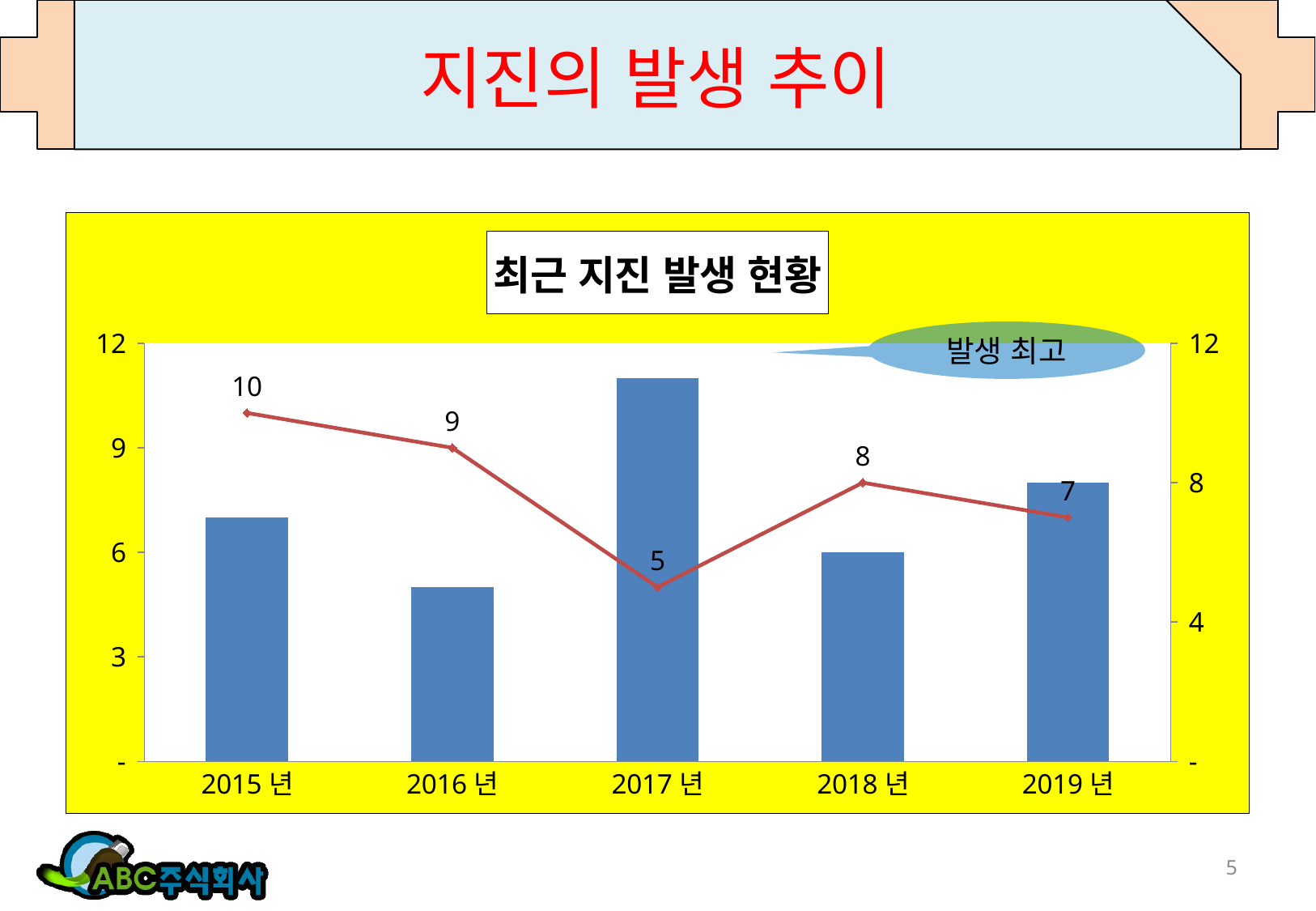
What is the difference between the line values for 2015 년 and 2017 년? 5 Which year has the larger line value, 2016 년 or 2018 년? 2016 년 On the left axis, is the bar for 2016 년 greater or less than 6? less In which year does the line series reach its lowest value? 2017 년 In which year does the line series reach its highest value? 2015 년 What is the title of the chart? 최근 지진 발생 현황 What is the value of the line series for 2015 년? 10 What is the value of the line series for 2017 년? 5 On the left axis, is the bar for 2017 년 greater or less than 9? greater Which year has the tallest bar? 2017 년 How many years are shown on the x axis? 5 What is the value of the line series for 2019 년? 7